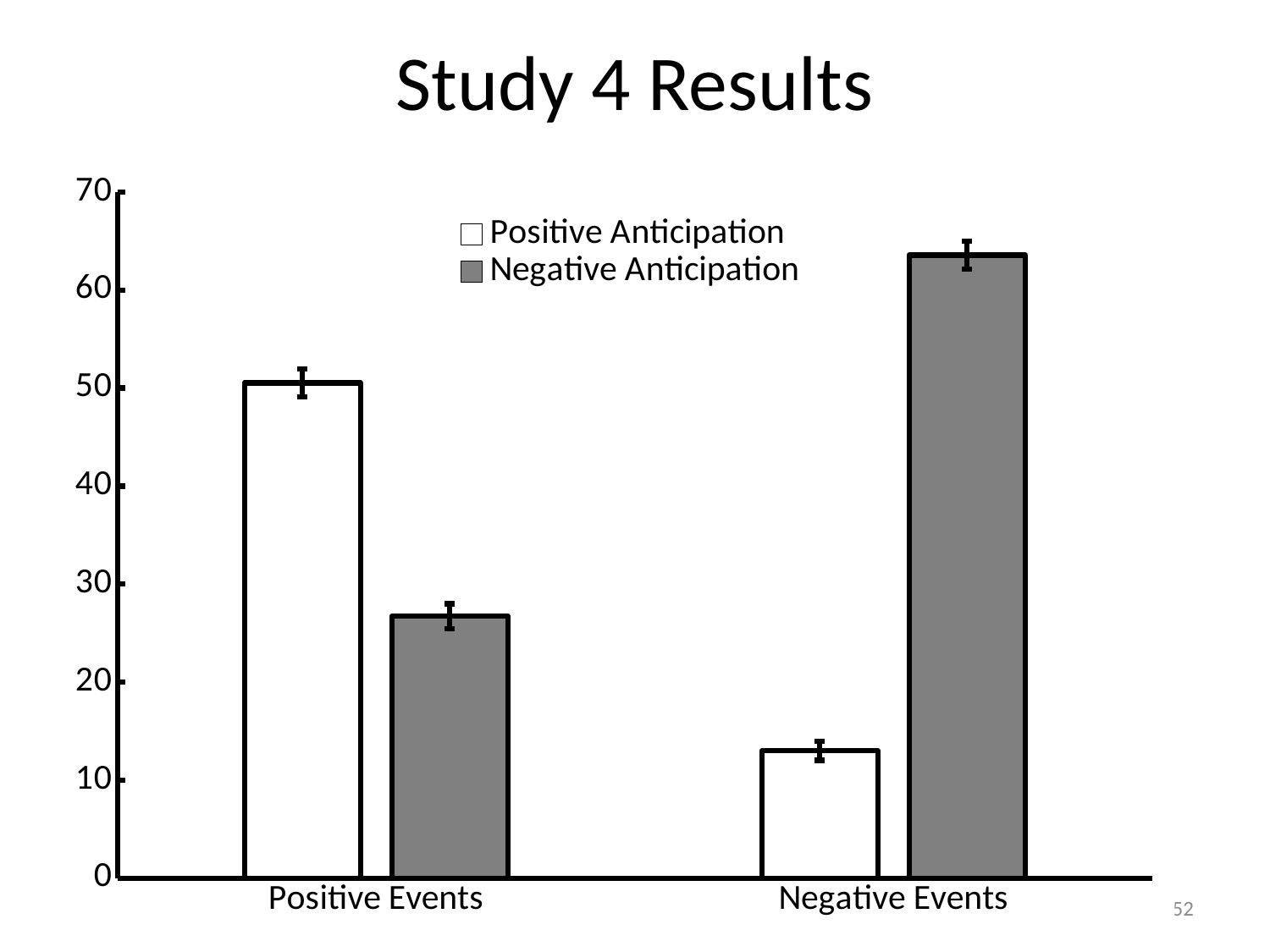
Is the value for Positive Anticipation for Positive Events greater or less than 40? greater How many series does the legend list? 2 For Negative Events, which is larger: Positive Anticipation or Negative Anticipation? Negative Anticipation What kind of chart is shown on the slide? bar chart Which bar is the lowest on the chart? Positive Anticipation for Negative Events Is the value for Negative Anticipation for Positive Events greater or less than 30? less For Positive Events, which is larger: Positive Anticipation or Negative Anticipation? Positive Anticipation What is the title of the slide? Study 4 Results Is the value for Negative Anticipation for Negative Events greater or less than 60? greater Which series has the tallest bar on the chart? Negative Anticipation How many event categories are shown on the x axis? 2